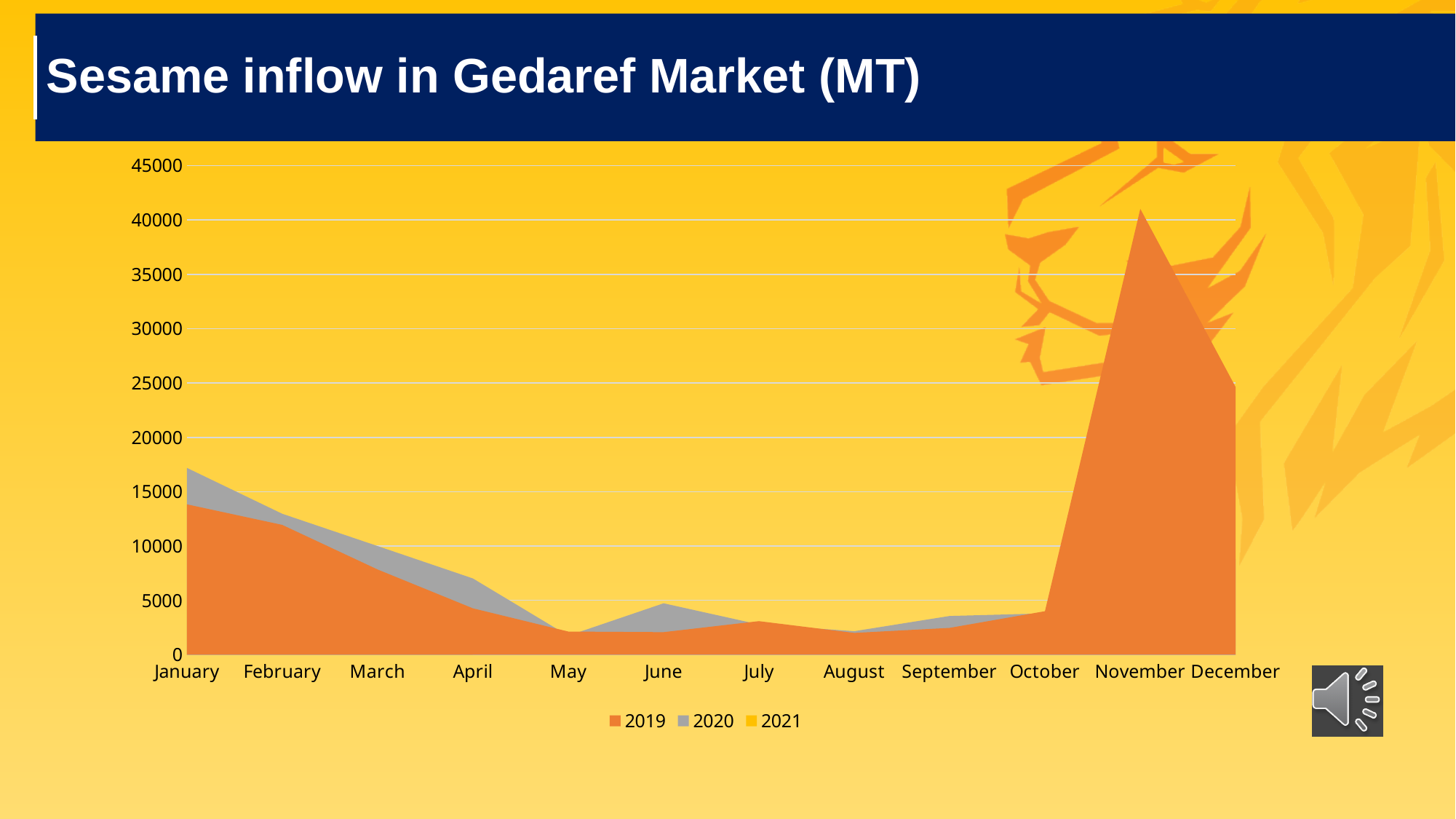
Is the 2019 value for November greater or less than 35000? greater How many months are shown along the x axis? 12 Is the 2019 value for January greater or less than 15000? less What kind of chart is shown on the slide? Area chart Is the 2020 value for January greater or less than 15000? greater How many series does the legend list? 3 Which is larger, the 2019 value for January or the 2019 value for November? November Do the 2019 values rise or fall from January to May? fall What is the title of the chart? Sesame inflow in Gedaref Market (MT) In which month is the 2019 value highest? November